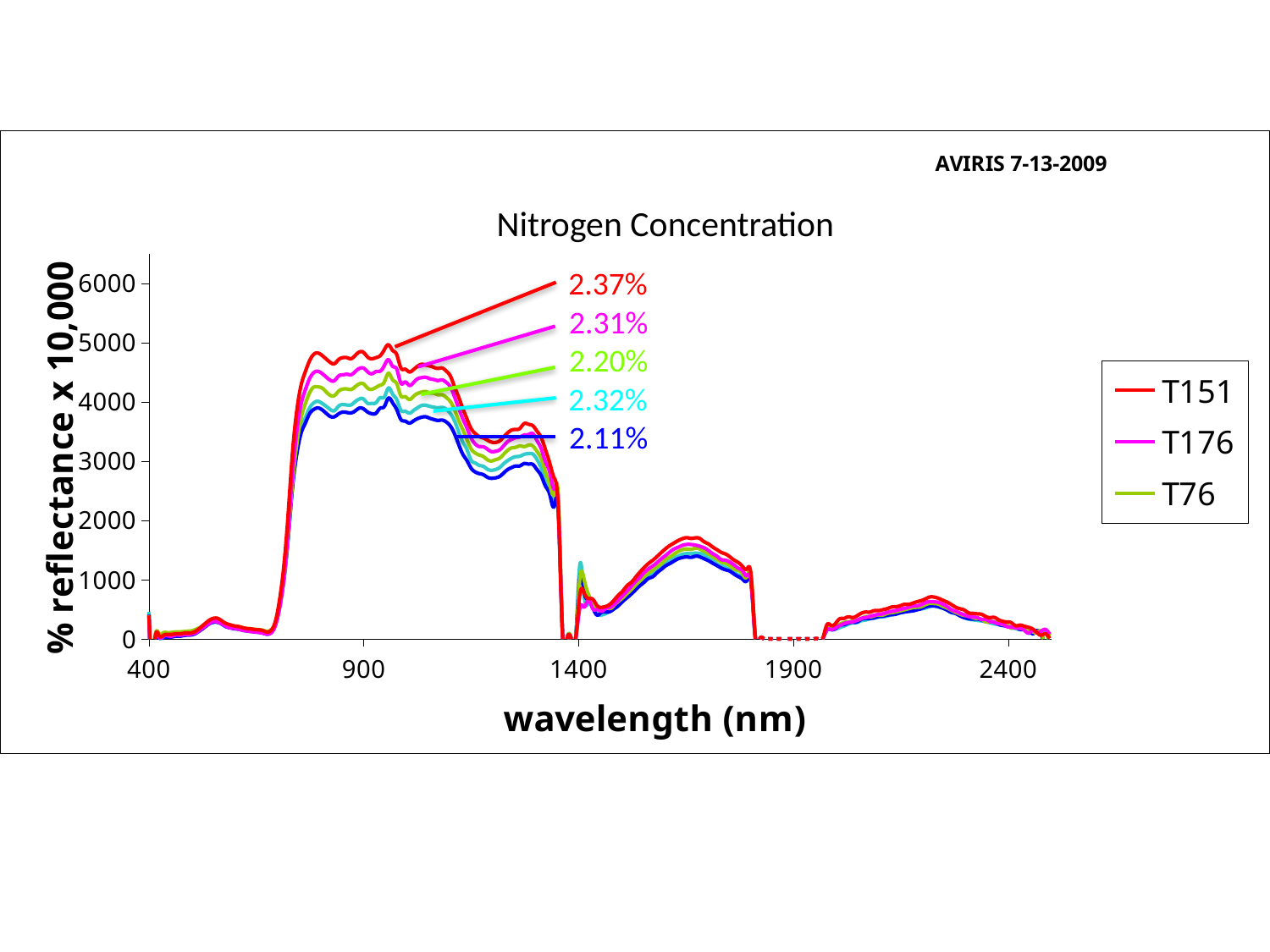
Is the peak reflectance of the T151 (red) line near 900 nm greater or less than 4000? greater How many series does the legend list? 3 What is the title of the chart? AVIRIS 7-13-2009 What nitrogen concentration is labelled for the T176 (magenta) line? 2.31% What kind of chart is shown on the slide? line chart What nitrogen concentration is labelled for the T76 (green) line? 2.20% Which legend series has the lowest labelled nitrogen concentration? T76 Which legend series has the highest labelled nitrogen concentration? T151 What is the difference between the nitrogen concentrations labelled for T151 and T76? 0.17% What is the label of the x axis? wavelength (nm) What nitrogen concentration is labelled for the T151 (red) line? 2.37% Which line has higher reflectance around 900 nm, T151 (red) or T76 (green)? T151